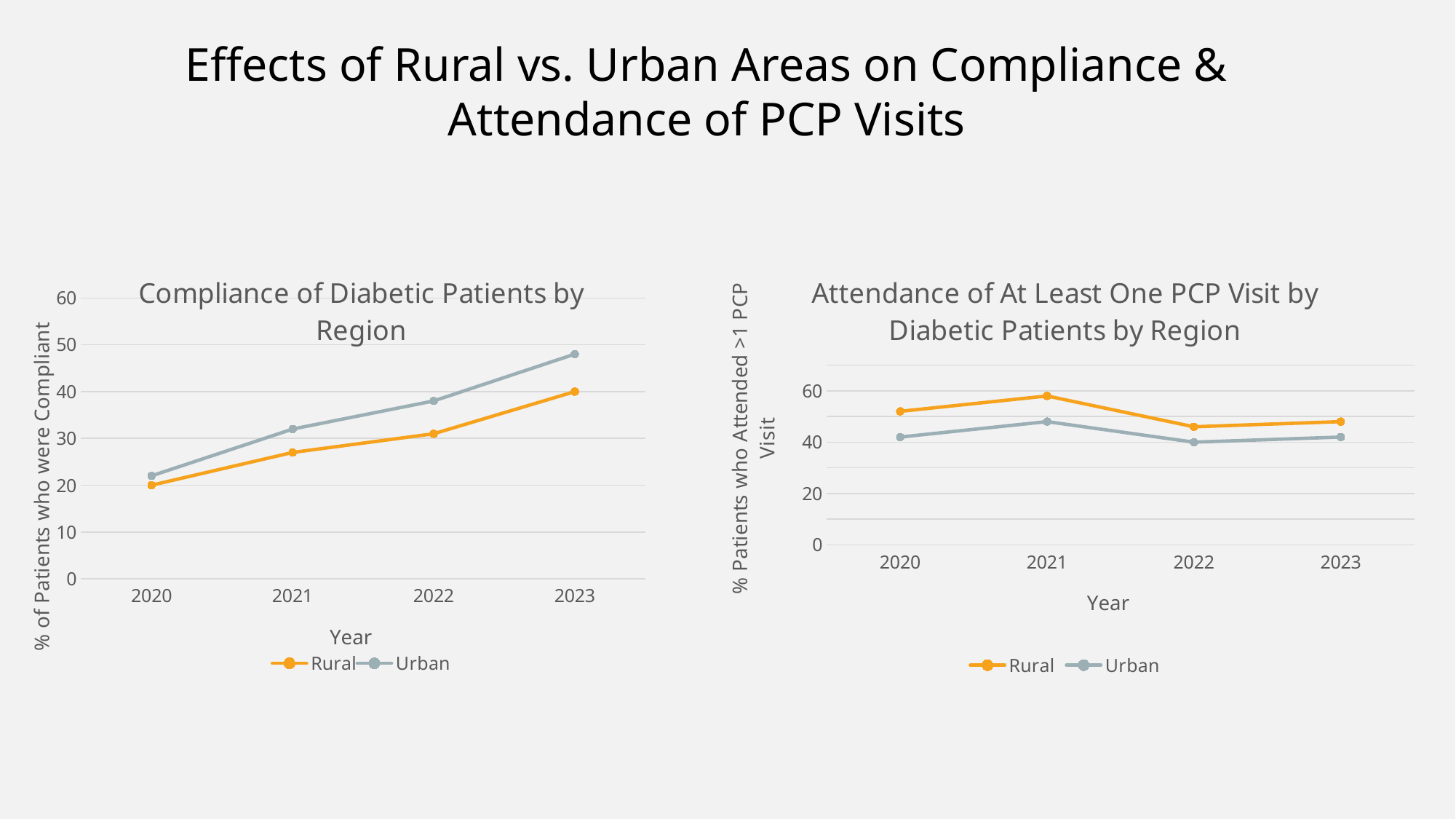
In the 'Attendance of At Least One PCP Visit by Diabetic Patients by Region' chart, which year has the highest Rural value? 2021 Which colour is used for the Rural series in both charts? orange In the 'Compliance of Diabetic Patients by Region' chart, do the Rural values rise or fall from 2020 to 2023? rise How many series does the legend of the 'Attendance of At Least One PCP Visit by Diabetic Patients by Region' chart list? 2 In the 'Compliance of Diabetic Patients by Region' chart, is the Urban value for 2023 greater or less than 40? greater In the 'Compliance of Diabetic Patients by Region' chart, which year has the highest Urban value? 2023 In the 'Attendance of At Least One PCP Visit by Diabetic Patients by Region' chart, which series is higher in 2020, Rural or Urban? Rural In the 'Compliance of Diabetic Patients by Region' chart, is the Rural value for 2021 greater or less than 30? less How many years are plotted on the x axis of the 'Compliance of Diabetic Patients by Region' chart? 4 In the 'Attendance of At Least One PCP Visit by Diabetic Patients by Region' chart, is the Urban value for 2021 greater or less than 40? greater In the 'Compliance of Diabetic Patients by Region' chart, which series is higher in 2022, Rural or Urban? Urban What type of chart is the 'Compliance of Diabetic Patients by Region' chart? line chart